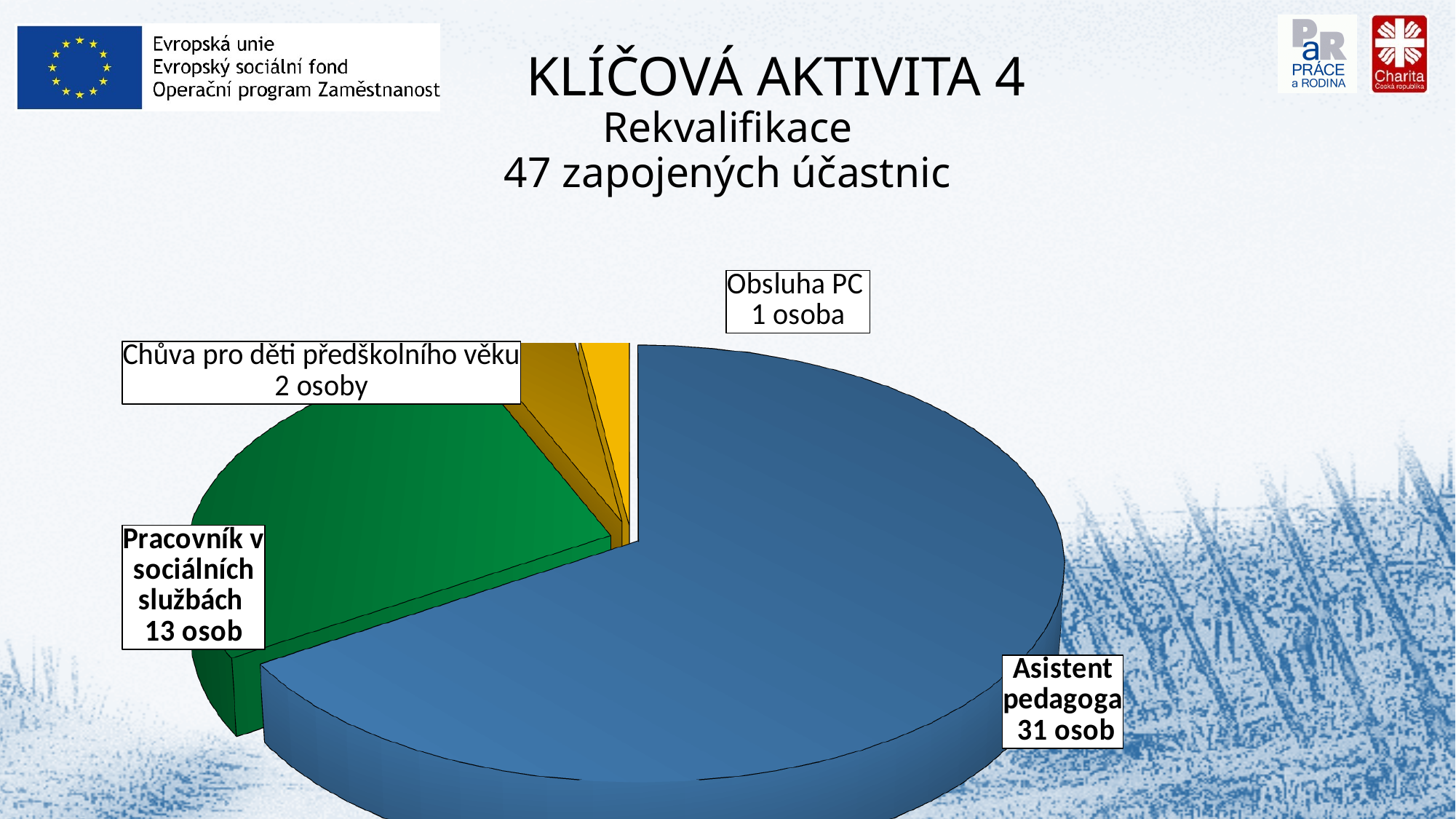
Which category has the smallest slice of the pie? Obsluha PC Which has more people, Chůva pro děti předškolního věku or Obsluha PC? Chůva pro děti předškolního věku How many people are in the Pracovník v sociálních službách slice? 13 osob How many people are in the Chůva pro děti předškolního věku slice? 2 osoby Which category has the largest slice of the pie? Asistent pedagoga How many slices does the pie chart have? 4 How many people are in the Asistent pedagoga slice? 31 osob What kind of chart is shown on the slide? Pie chart What is the difference between the number of people for Asistent pedagoga and Pracovník v sociálních službách? 18 What is the total number of participants stated in the chart's title? 47 What is the difference between the number of people for Pracovník v sociálních službách and Chůva pro děti předškolního věku? 11 How many people are in the Obsluha PC slice? 1 osoba